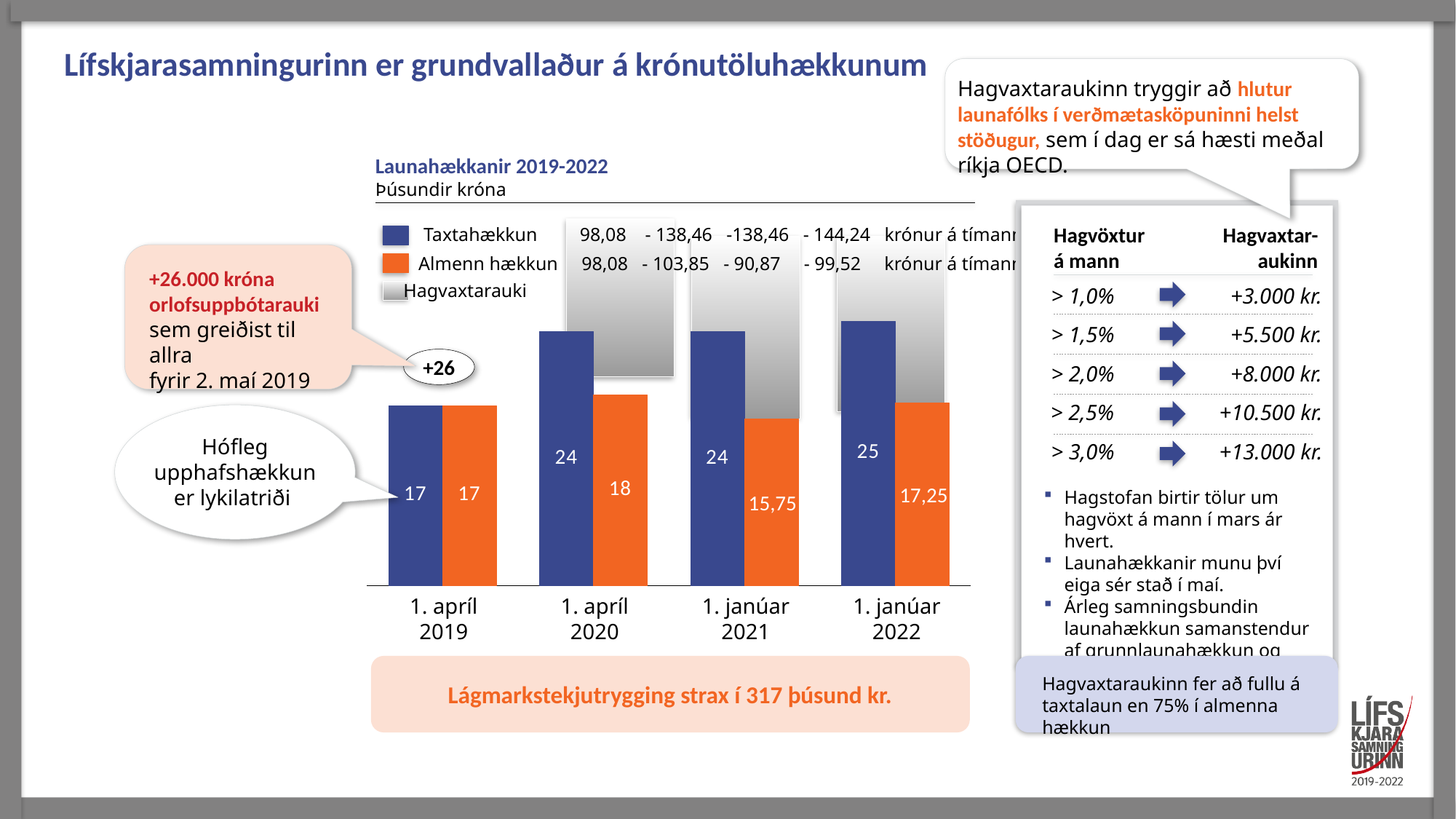
What is the Almenn hækkun value for 1. janúar 2021? 15,75 What is the Almenn hækkun value for 1. janúar 2022? 17,25 Which is larger for 1. apríl 2020: Taxtahækkun or Almenn hækkun? Taxtahækkun How many categories are shown on the x axis of the chart? 4 What is the Taxtahækkun value for 1. apríl 2020? 24 Which category has the highest Taxtahækkun value? 1. janúar 2022 What is the Taxtahækkun value for 1. apríl 2019? 17 What kind of chart is shown on the slide? bar chart What is the difference between the Taxtahækkun and Almenn hækkun values for 1. janúar 2021? 8,25 What is the title of the chart? Launahækkanir 2019-2022 Which category has the lowest Almenn hækkun value? 1. janúar 2021 How many series does the chart legend list? 3